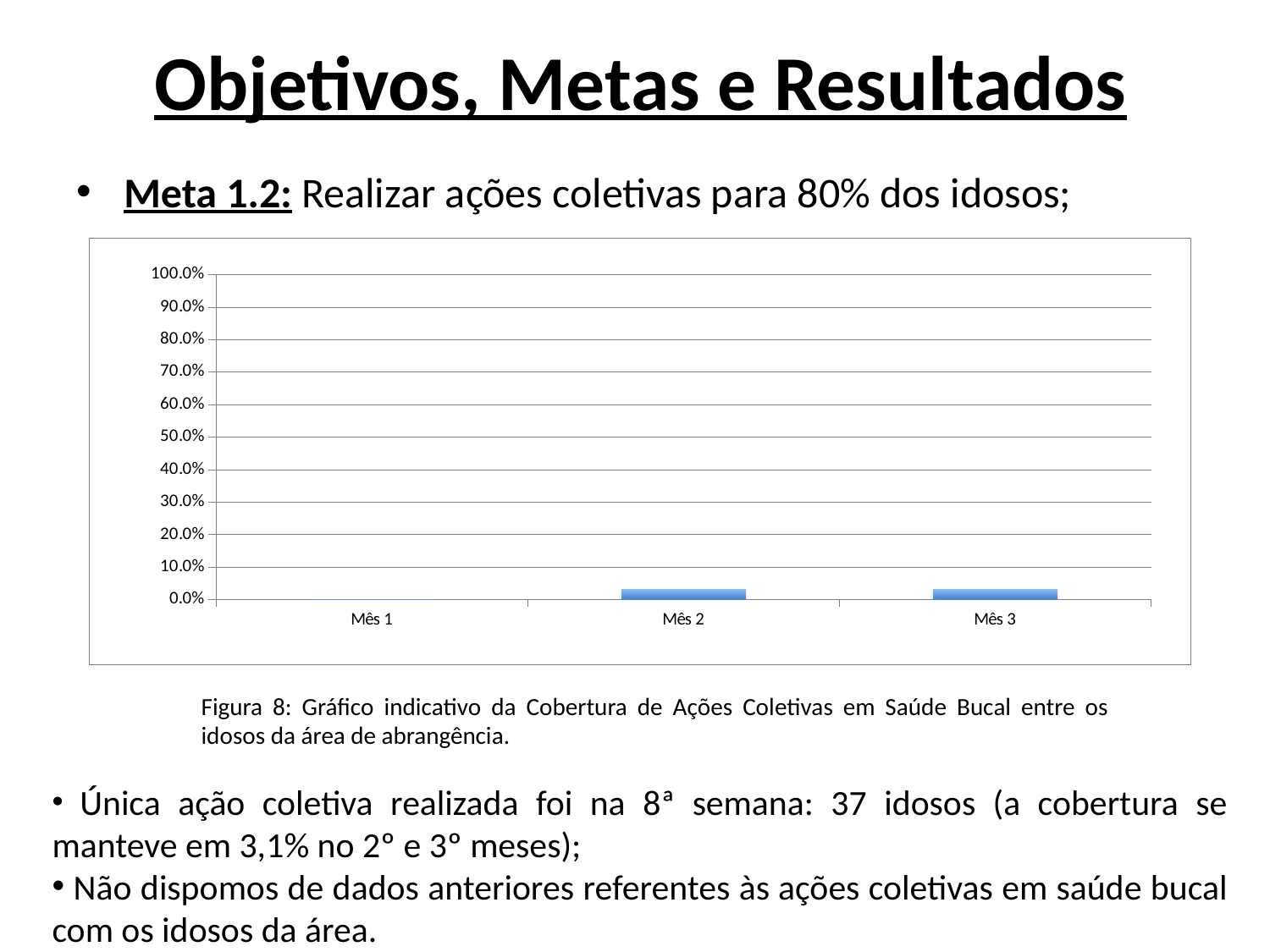
Which category has the lowest value in the chart? Mês 1 Is the value for Mês 1 greater or less than 10.0%? less Which is larger, the value for Mês 1 or the value for Mês 2? Mês 2 Is the value for Mês 2 greater or less than 10.0%? less What is the highest tick value shown on the y axis of the chart? 100.0% Which is larger, the value for Mês 1 or the value for Mês 3? Mês 3 What is the label of the first category on the x axis? Mês 1 What kind of chart is shown on the slide? bar chart Is the value for Mês 3 greater or less than 80.0%? less How many categories are shown on the x axis of the chart? 3 Does the value rise or fall from Mês 1 to Mês 2? rise